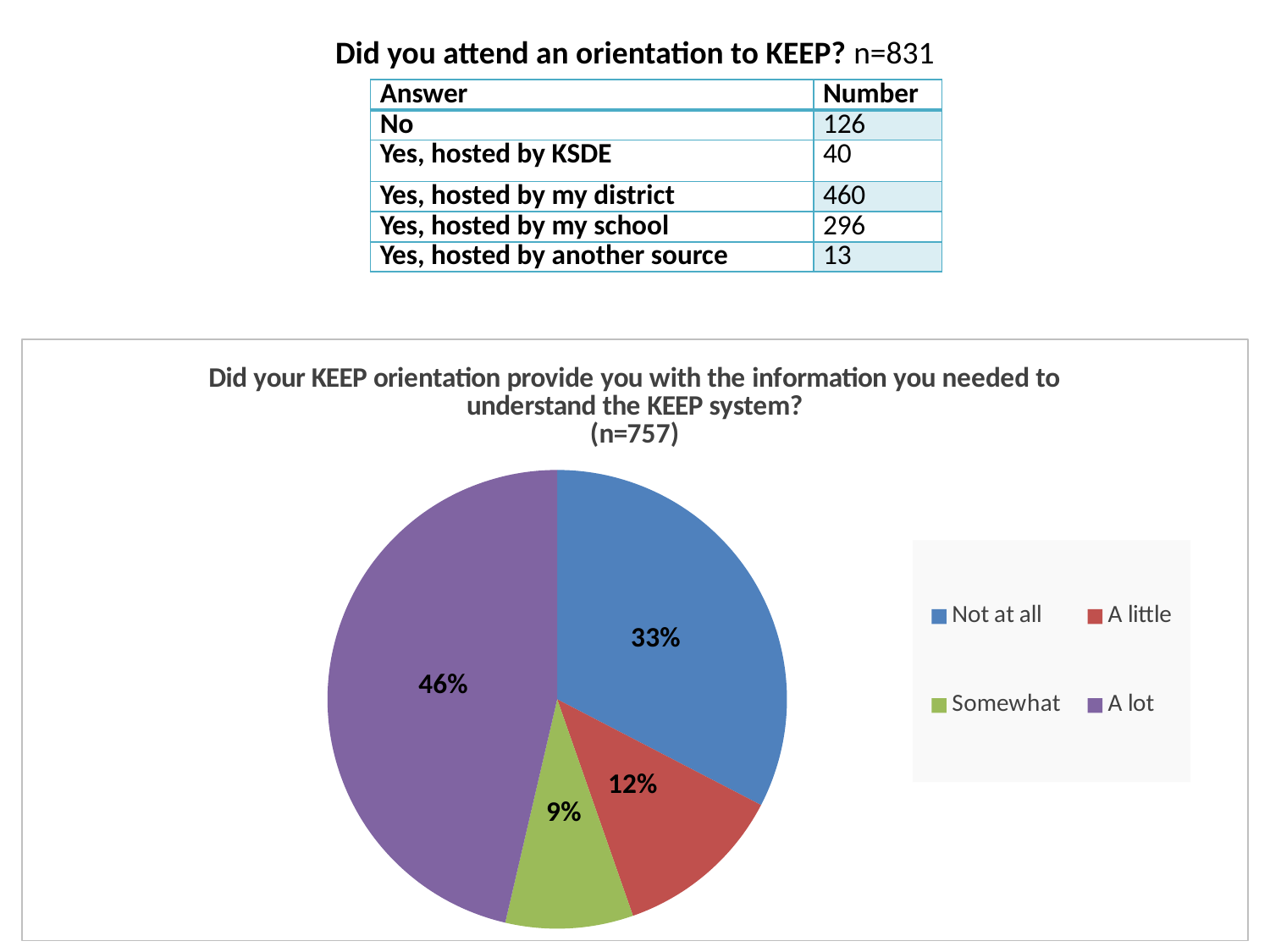
What type of chart is shown on the slide? pie chart What share of the pie chart is labelled "A lot"? 46% Which category has the smallest slice in the pie chart? Somewhat Which slice is larger in the pie chart, "A little" or "Somewhat"? A little What share of the pie chart is labelled "A little"? 12% What sample size (n) is given in the pie chart's title? n=757 How many entries does the pie chart's legend list? 4 Which category has the largest slice in the pie chart? A lot How many slices does the pie chart have? 4 What share of the pie chart is labelled "Somewhat"? 9% What is the difference in percentage points between the "A lot" slice and the "Not at all" slice? 13